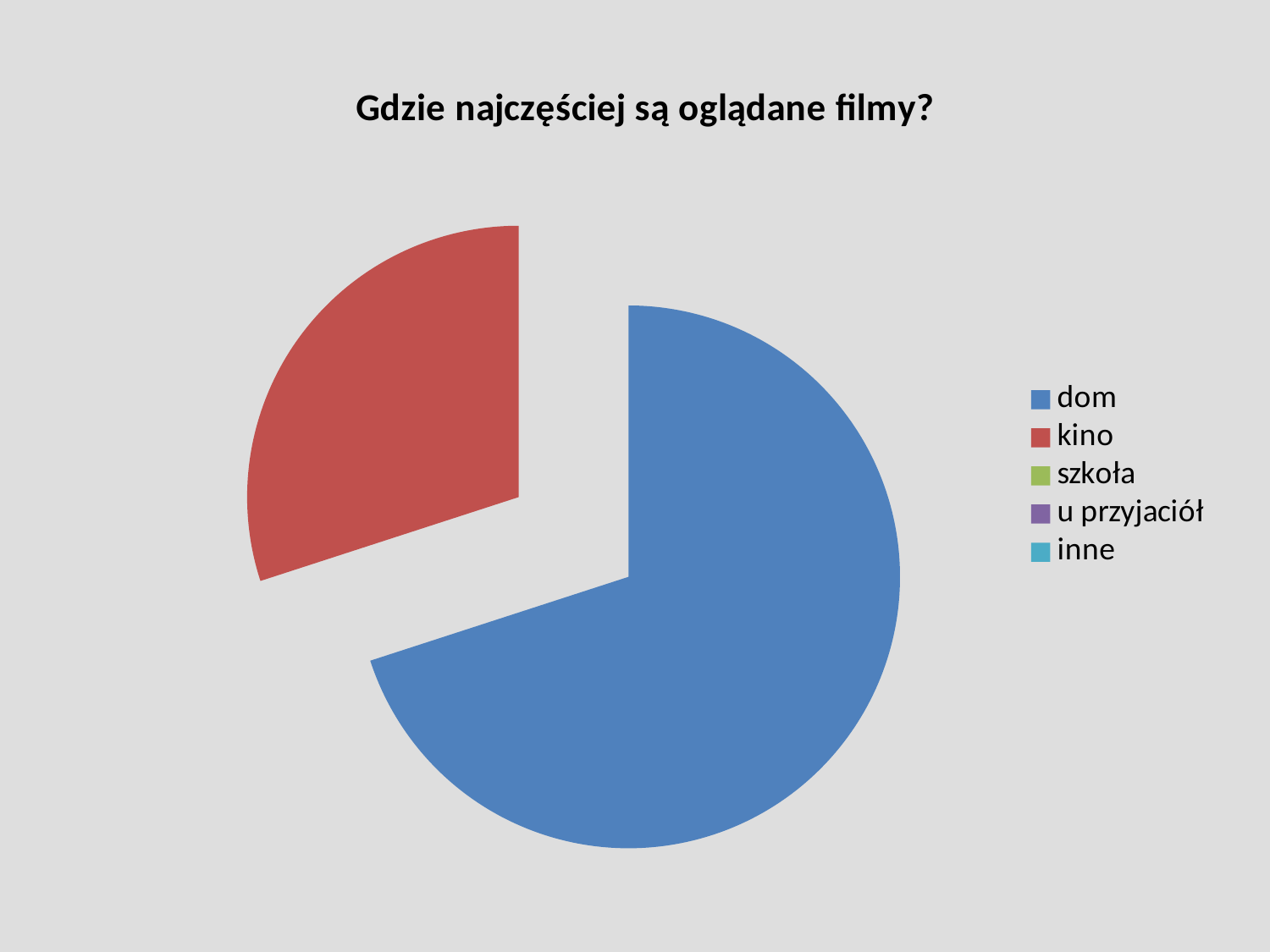
Which category has the largest slice of the pie? dom How many slices are visible in the pie? 2 What colour is the slice for kino? red What is the title of the chart? Gdzie najczęściej są oglądane filmy? What kind of chart is shown on the slide? pie chart How many entries does the legend list? 5 Which slice is larger, dom or kino? dom Which legend entry is shown in blue? dom